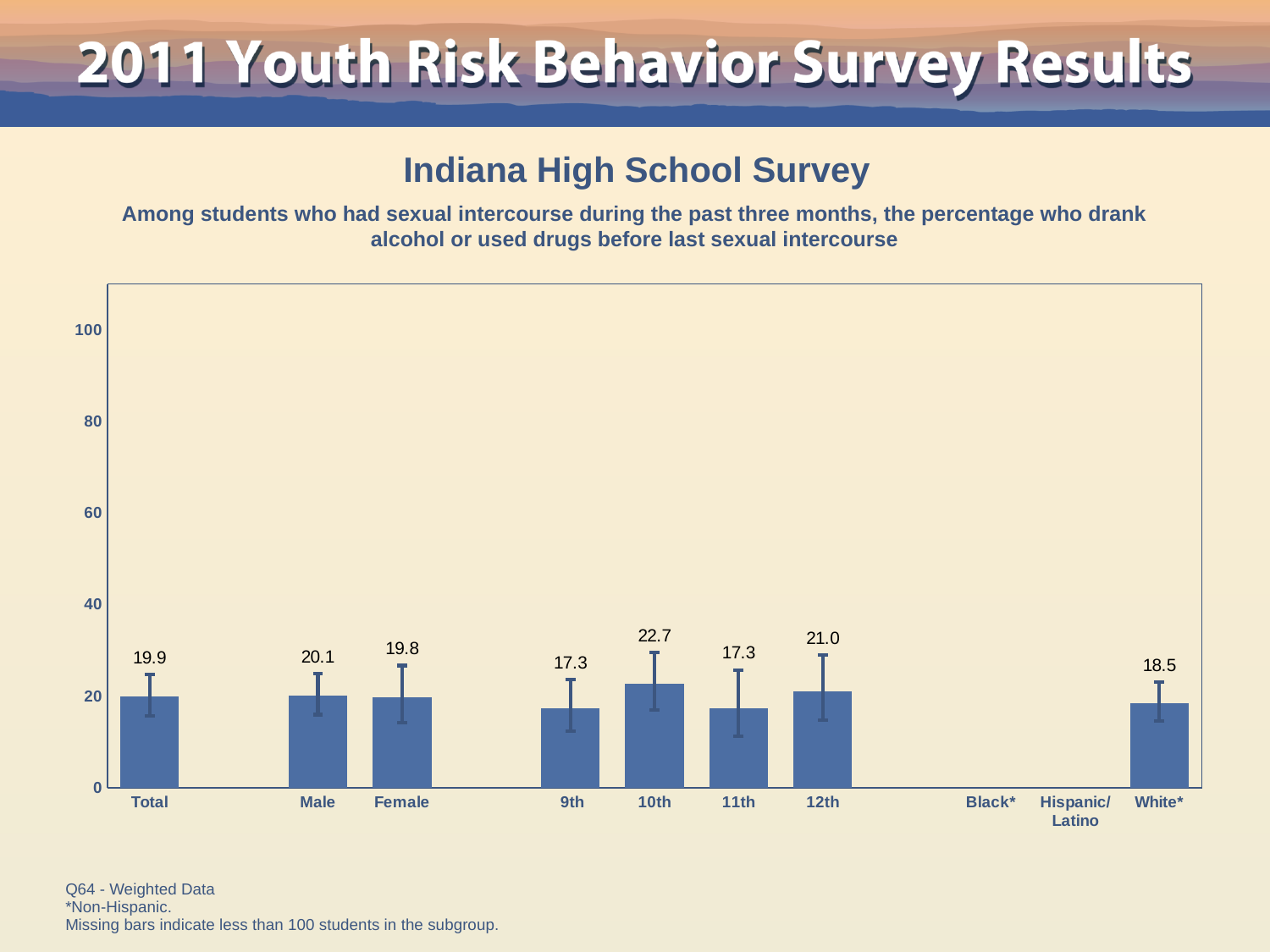
Is the value for 10th grade greater or less than 20? greater How many categories are labeled on the x axis? 10 Which is larger, the value for 12th grade or the value for 11th grade? 12th What is the value for Female? 19.8 What is the value for Total? 19.9 What is the difference between the values for 10th and 9th grade? 5.4 What is the difference between the values for Male and Female? 0.3 What is the value for White*? 18.5 What kind of chart is shown? bar chart Which categories have no bar shown? Black* and Hispanic/Latino Which category has the highest value? 10th What is the value for 10th grade? 22.7